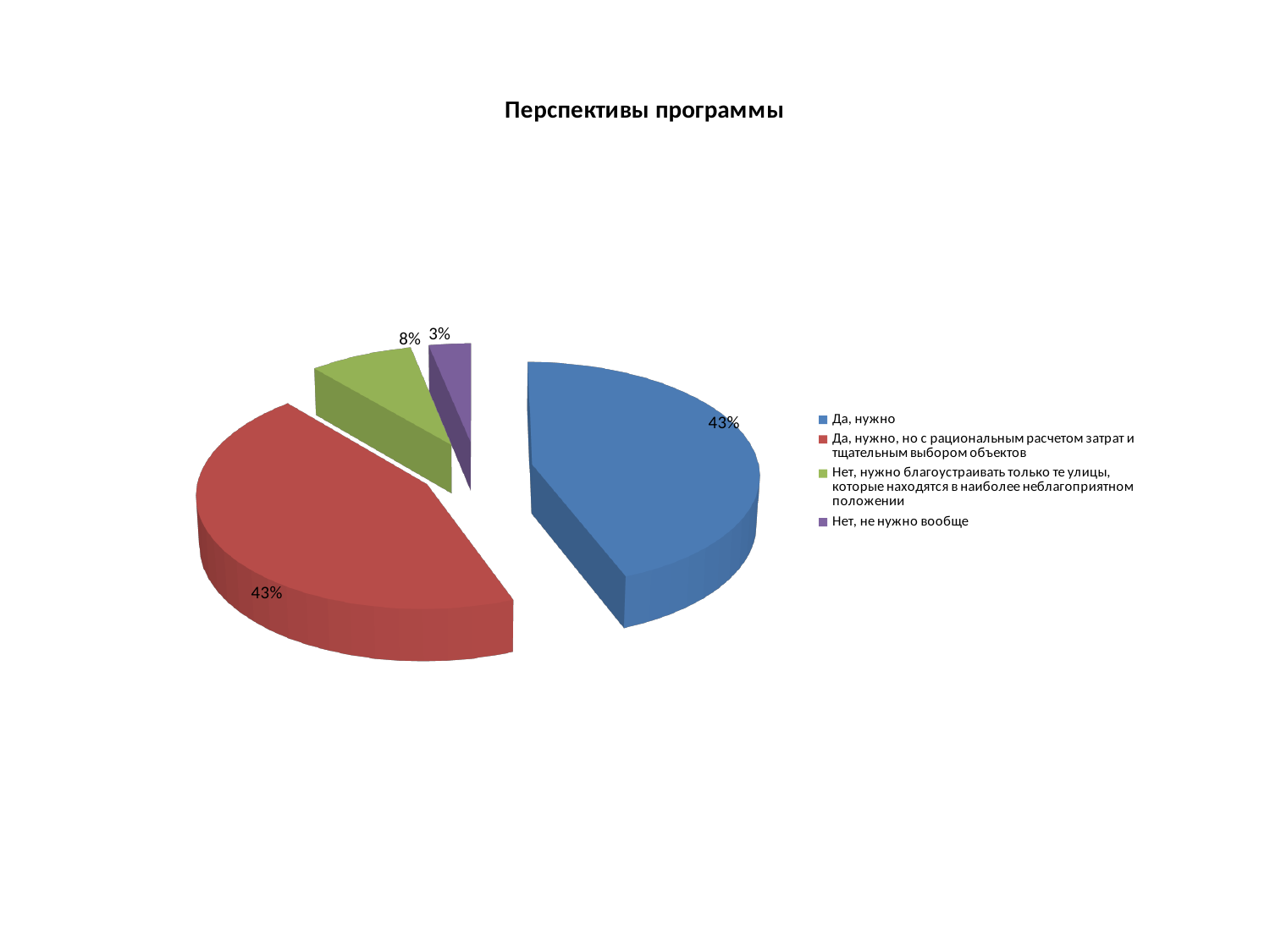
What percentage is shown for "Нет, нужно благоустраивать только те улицы, которые находятся в наиболее неблагоприятном положении"? 8% What percentage is shown for "Да, нужно, но с рациональным расчетом затрат и тщательным выбором объектов"? 43% What type of chart is shown on the slide? Pie chart What is the title of the chart? Перспективы программы What share of the pie is labelled for "Да, нужно"? 43% Which category has the smallest slice of the pie? Нет, не нужно вообще What percentage is shown for "Нет, не нужно вообще"? 3% What is the difference in percentage points between the "Да, нужно" slice and the "Нет, не нужно вообще" slice? 40% Which is larger: the slice for "Нет, нужно благоустраивать только те улицы..." or the slice for "Нет, не нужно вообще"? Нет, нужно благоустраивать только те улицы... What colour is the slice for "Да, нужно"? Blue What is the combined share of the two "Нет" categories? 11% How many categories does the legend list? 4